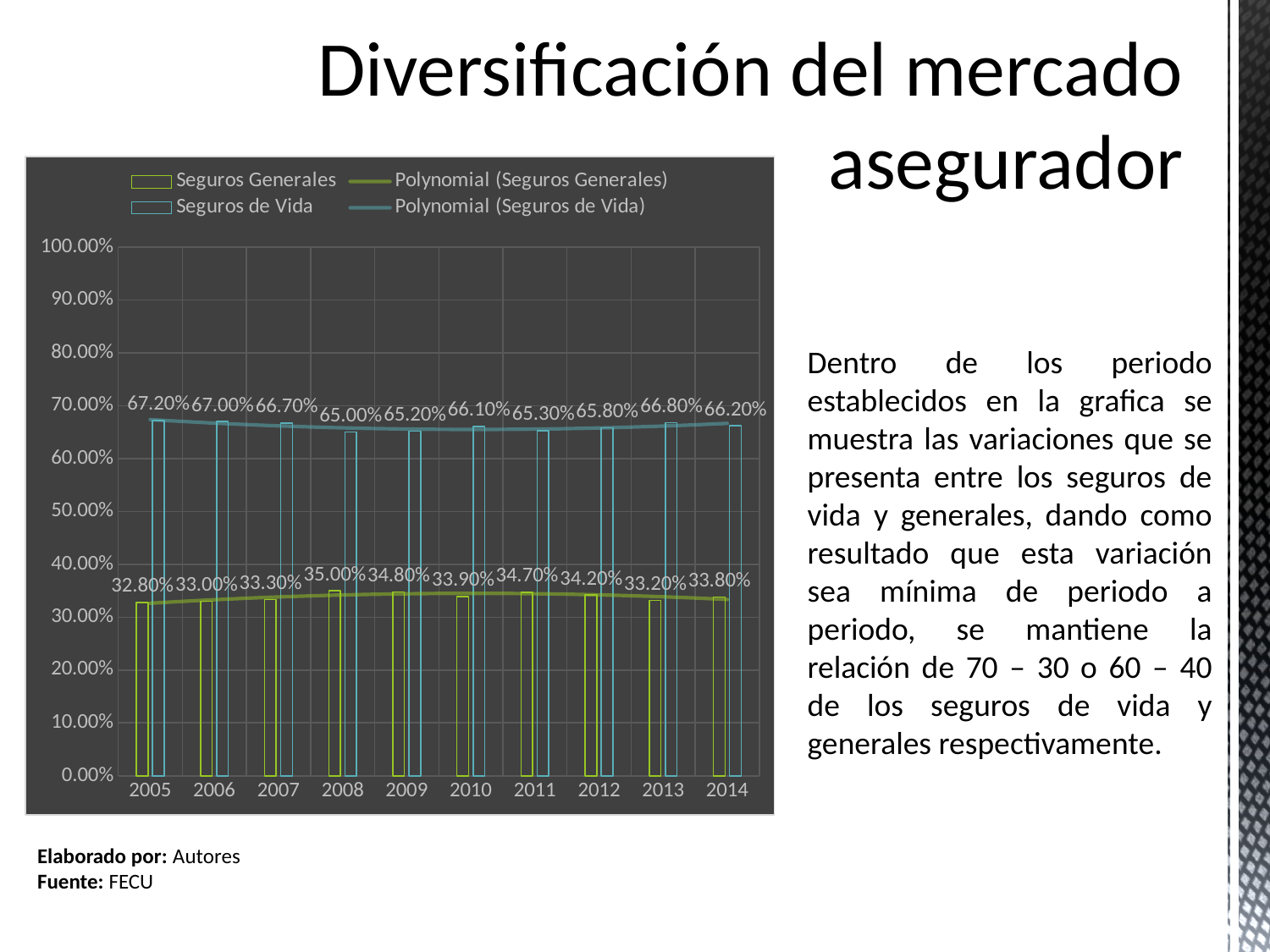
How many years are shown on the x axis? 10 In which year is Seguros de Vida lowest? 2008 Is the value for Seguros Generales in 2005 greater or less than 40.00%? less What is the value for Seguros Generales in 2008? 35.00% What kind of chart is shown on the slide? bar chart What is the value for Seguros de Vida in 2013? 66.80% How many entries does the legend list? 4 What is the difference between Seguros de Vida and Seguros Generales in 2014? 32.40% In which year is Seguros Generales highest? 2008 What is the total of Seguros Generales and Seguros de Vida in 2009? 100.00% Which is larger in 2010: Seguros Generales or Seguros de Vida? Seguros de Vida What is the value for Seguros de Vida in 2005? 67.20%